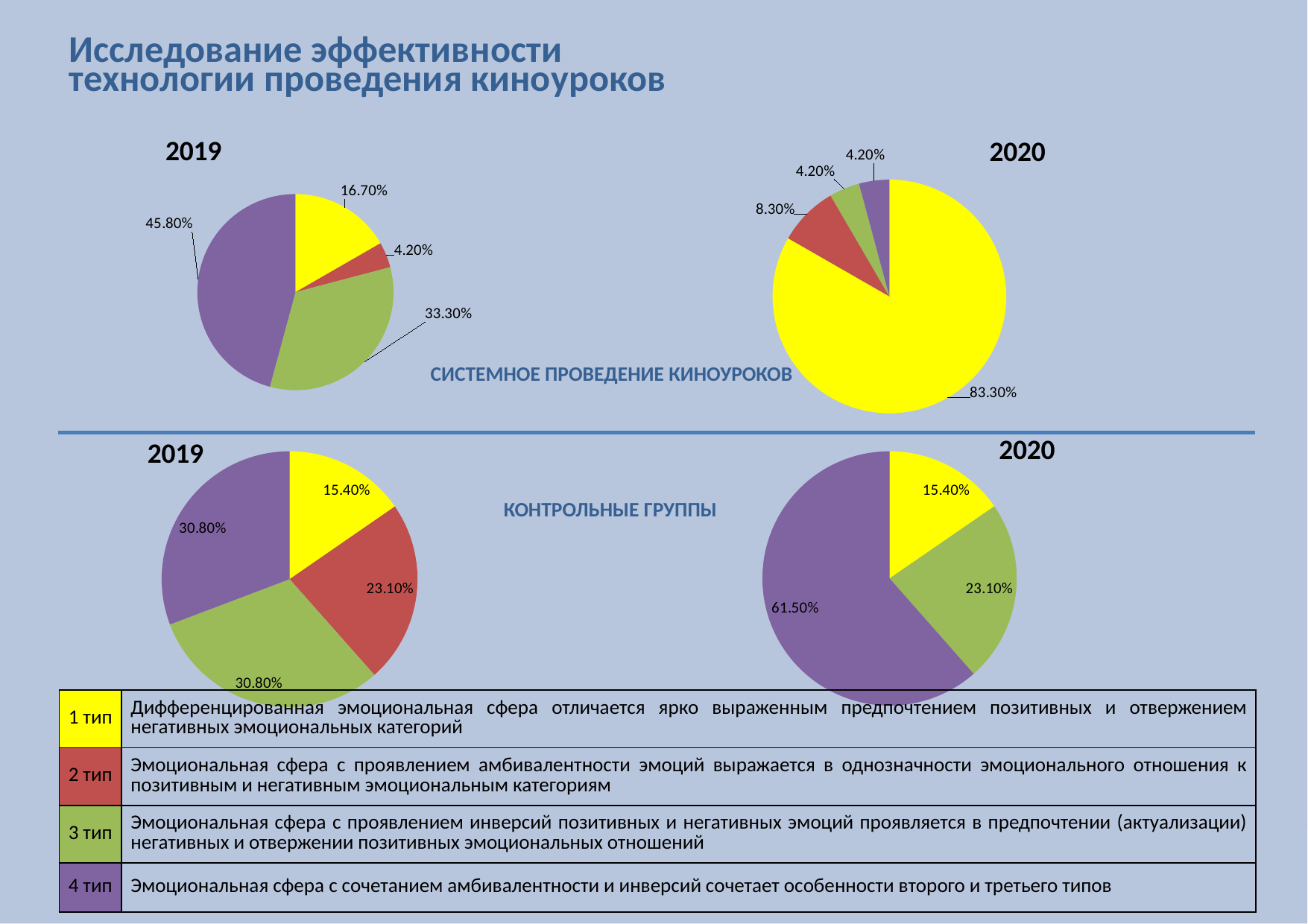
What kind of charts are shown on the slide? Pie charts In the bottom-right pie chart (2020, контрольные группы), what share does the purple slice (4 тип) have? 61.50% In the bottom-left pie chart (2019, контрольные группы), what share does the red slice (2 тип) have? 23.10% In the top-left pie chart (2019, системное проведение киноуроков), what share does the purple slice (4 тип) have? 45.80% In the top-left pie chart (2019, системное проведение киноуроков), which type has the largest share? 4 тип In the bottom-left pie chart (2019, контрольные группы), which type has the smallest share? 1 тип In the bottom-right pie chart (2020, контрольные группы), how many slices does the pie have? 3 In the bottom-left pie chart (2019, контрольные группы), which is larger: the green slice (3 тип) or the red slice (2 тип)? 3 тип (green) In the top-left pie chart (2019, системное проведение киноуроков), what is the difference between the green slice (33.30%) and the yellow slice (16.70%)? 16.60% In the top-right pie chart (2020, системное проведение киноуроков), which type has the largest share? 1 тип In the top-right pie chart (2020, системное проведение киноуроков), what share does the yellow slice (1 тип) have? 83.30% In the top-right pie chart (2020, системное проведение киноуроков), what share does the red slice (2 тип) have? 8.30%